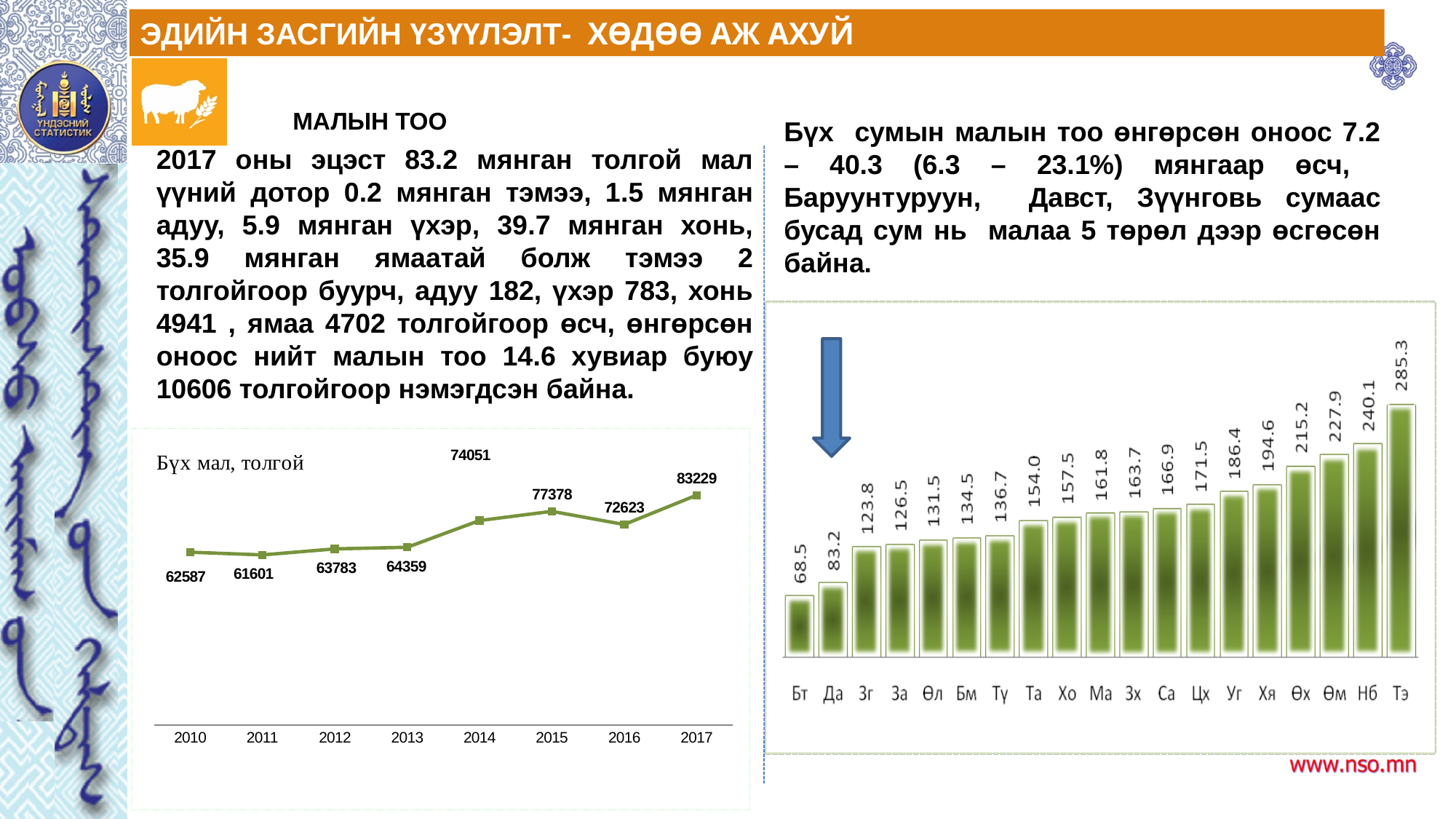
What kind of chart is the chart titled 'Бүх мал, толгой' on the left? line chart In the bar chart on the right, which category has the lowest value? Бт In the bar chart on the right, how many categories are shown? 19 In the line chart titled 'Бүх мал, толгой' on the left, which year has the highest value? 2017 In the bar chart on the right, what is the value for Да? 83.2 In the line chart titled 'Бүх мал, толгой' on the left, how many years are plotted? 8 In the line chart titled 'Бүх мал, толгой' on the left, what is the value for 2014? 74051 In the bar chart on the right, what is the value for Тэ? 285.3 In the line chart titled 'Бүх мал, толгой' on the left, what is the difference between the 2017 value and the 2016 value? 10606 In the line chart titled 'Бүх мал, толгой' on the left, which year has the lowest value? 2011 In the bar chart on the right, do the values rise or fall from left to right? rise In the line chart titled 'Бүх мал, толгой' on the left, what is the value for 2017? 83229